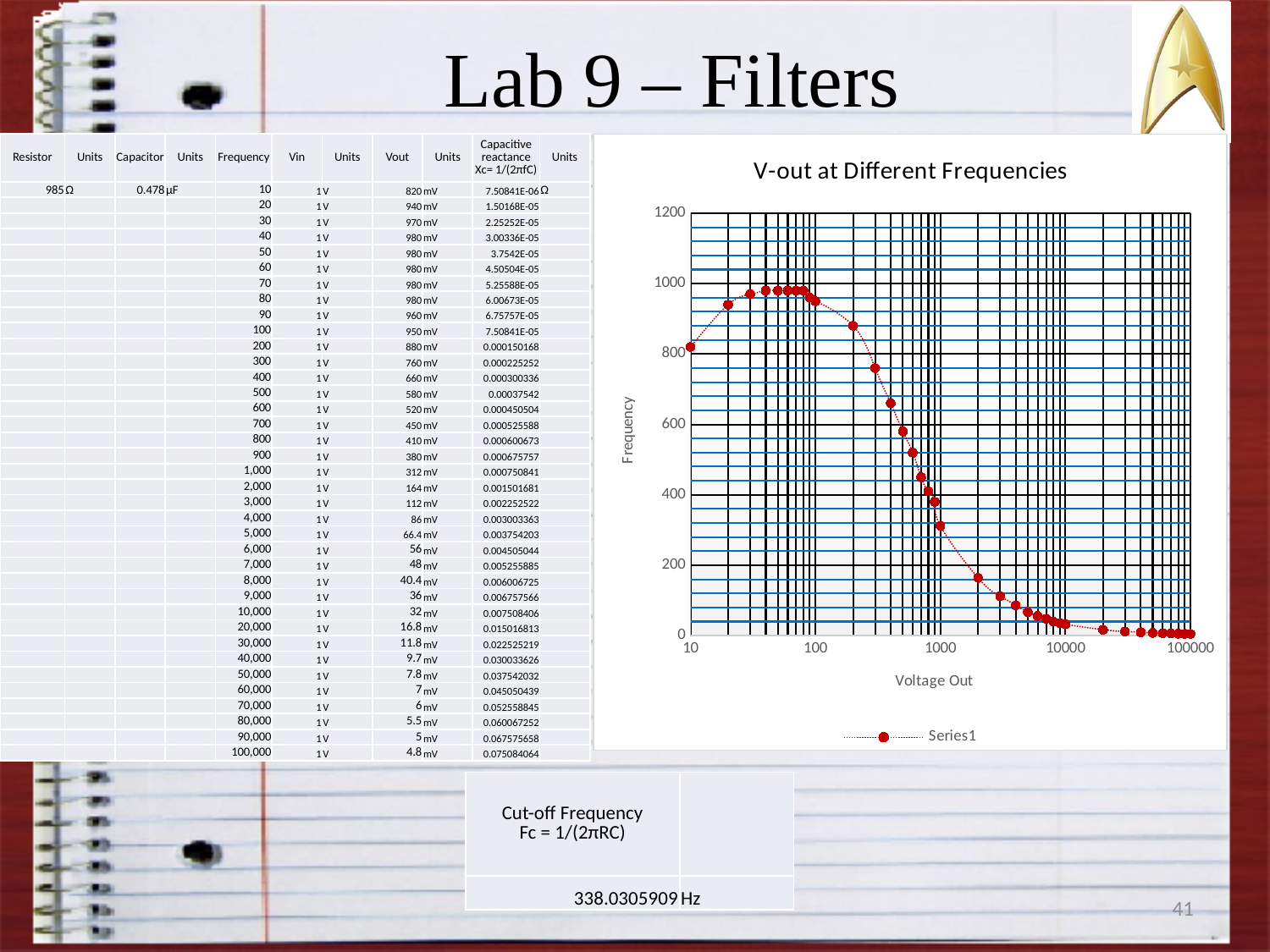
In the chart, is the value at x = 100000 greater or less than 200? less What kind of chart is shown on the slide? scatter chart In the chart, do the values rise or fall as x increases from 1000 to 100000? fall In the chart, is the value at x = 100 greater or less than 800? greater In the chart, which is larger: the value at x = 100 or the value at x = 1000? the value at x = 100 In the chart, is the value at x = 1000 greater or less than 400? less What is the highest tick value shown on the chart's vertical axis? 1200 How many series does the chart's legend list? 1 What is the name of the series shown in the chart legend? Series1 What is the title of the chart on the slide? V-out at Different Frequencies